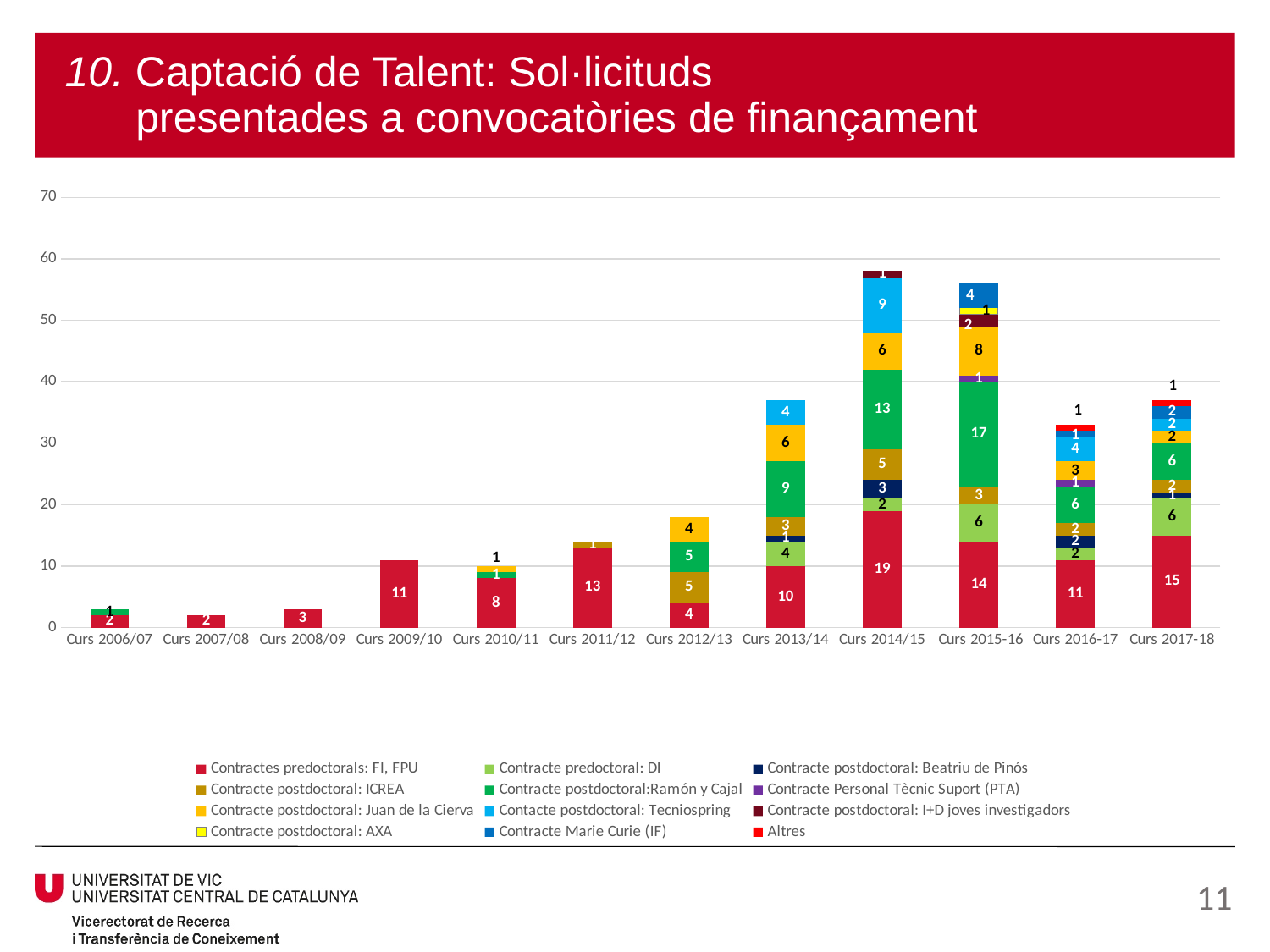
Which is larger: the Ramón y Cajal value in Curs 2015-16 or in Curs 2014/15? Curs 2015-16 What is the value for Contacte postdoctoral: Tecniospring in Curs 2014/15? 9 What kind of chart is shown on the slide? Stacked bar chart What is the total of the stacked bar for Curs 2012/13? 18 How many series does the legend list? 12 What is the difference between the FI, FPU values for Curs 2014/15 and Curs 2013/14? 9 Is the total height of the Curs 2014/15 bar greater or less than 50? greater What is the value for Contractes predoctorals: FI, FPU in Curs 2014/15? 19 What is the value for Contracte postdoctoral: Ramón y Cajal in Curs 2015-16? 17 How many academic years (Curs) are shown on the x axis? 12 Which academic year has the highest value for Contractes predoctorals: FI, FPU? Curs 2014/15 What is the value for Contractes predoctorals: FI, FPU in Curs 2009/10? 11